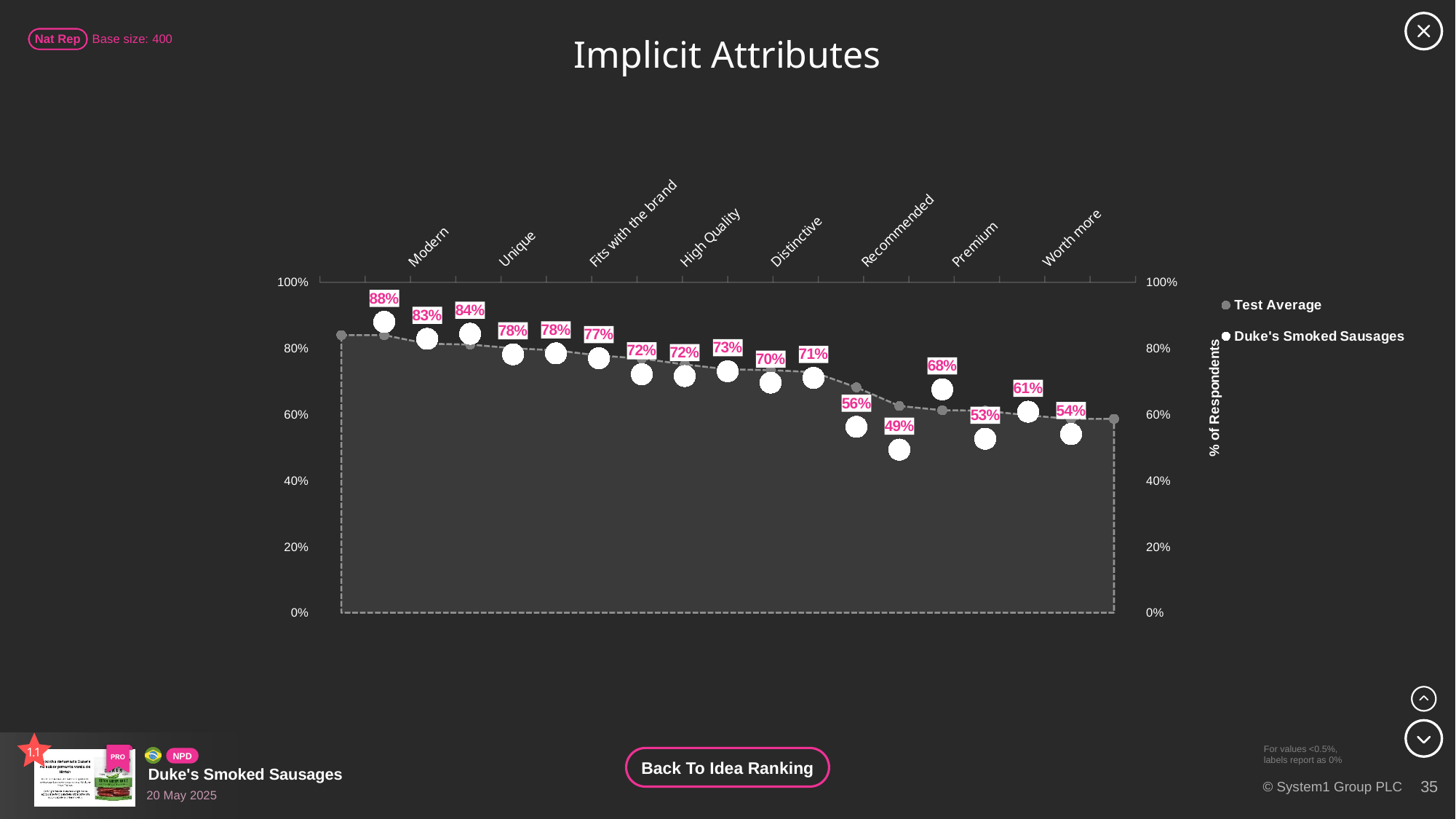
How many data labels are shown for the Duke's Smoked Sausages series? 17 Is the lowest labelled value for Duke's Smoked Sausages greater or less than 60%? less What is the lowest value shown by a data label for Duke's Smoked Sausages? 49% Do the Duke's Smoked Sausages values generally rise or fall from left to right across the chart? fall Which is larger, the first labelled value (88%) or the last labelled value (54%) for Duke's Smoked Sausages? 88% How many series does the legend list? 2 What is the difference between the highest (88%) and lowest (49%) labelled values for Duke's Smoked Sausages? 39 percentage points What are the two series named in the legend? Test Average and Duke's Smoked Sausages What type of chart is shown on the slide? combination area and line chart What is the highest value shown by a data label for Duke's Smoked Sausages? 88% How many attribute labels are printed along the top of the chart? 8 What is the title of the chart? Implicit Attributes